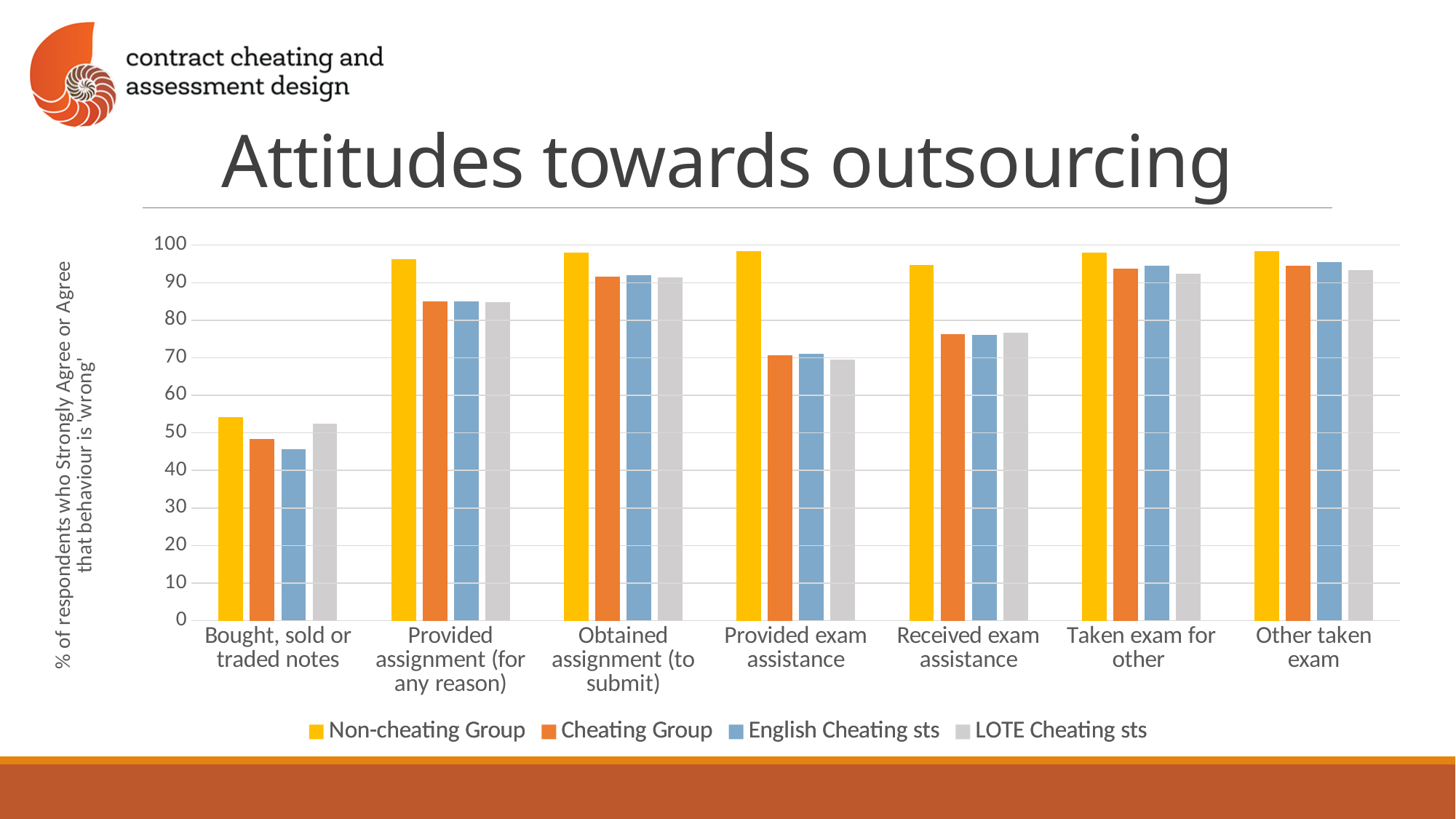
Is the value for the Non-cheating Group for 'Bought, sold or traded notes' greater or less than 50? greater For 'Provided exam assistance', which is larger: the Non-cheating Group or the Cheating Group? Non-cheating Group How many behaviour categories are shown along the x axis? 7 Is the value for English Cheating sts for 'Bought, sold or traded notes' greater or less than 50? less How many series does the legend list? 4 For the Cheating Group, which category has the lowest value? Bought, sold or traded notes What colour represents the Non-cheating Group in the legend? yellow Is the value for the Cheating Group for 'Provided exam assistance' greater or less than 80? less For the Non-cheating Group, which category has the lowest value? Bought, sold or traded notes What kind of chart is shown on the slide? bar chart For the Cheating Group, which is larger: 'Provided exam assistance' or 'Received exam assistance'? Received exam assistance